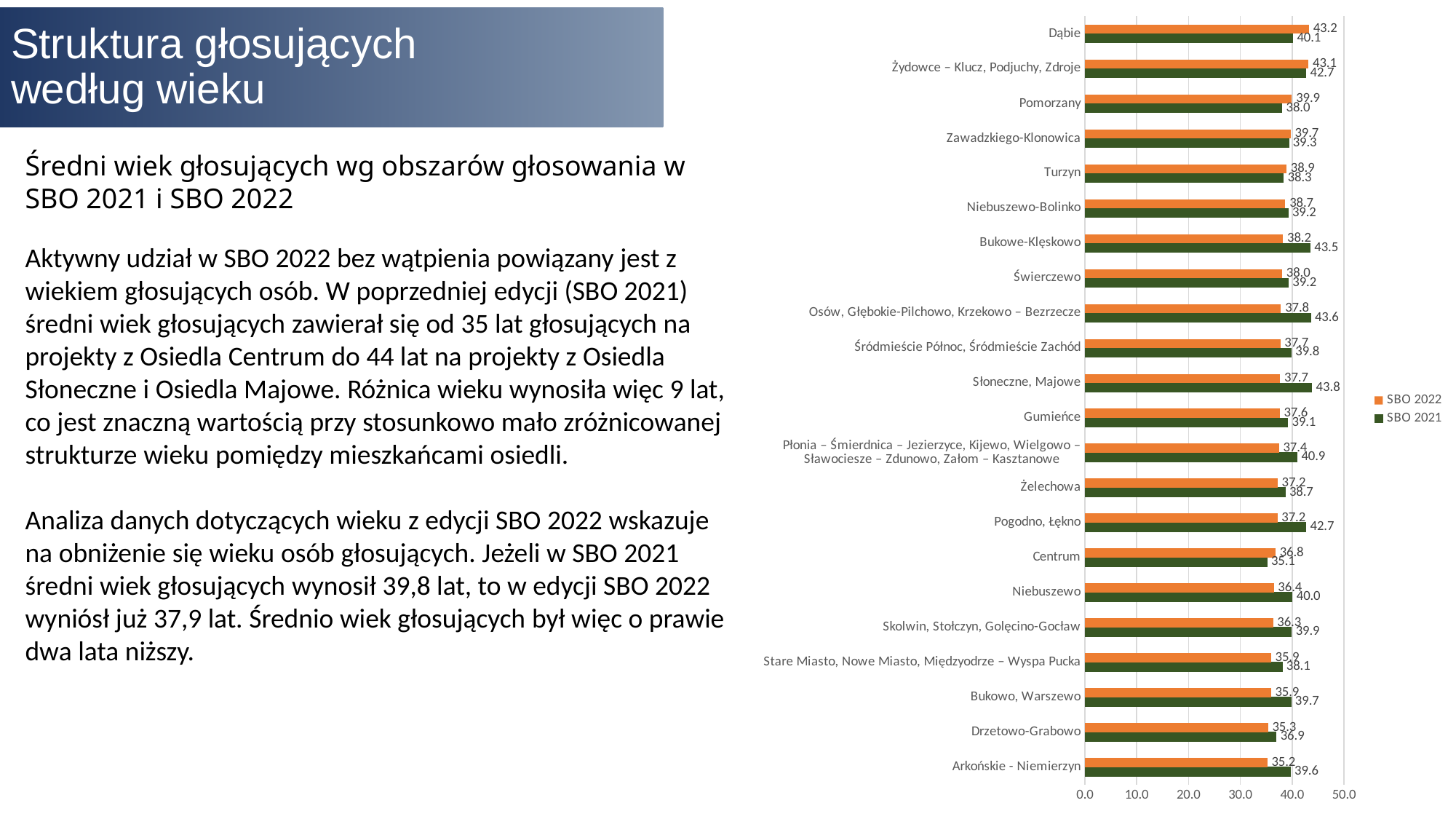
What kind of chart is shown on the slide? bar chart Which area has the highest SBO 2022 value? Dąbie What is the difference between the SBO 2021 and SBO 2022 values for Pogodno, Łękno? 5.5 Is the SBO 2021 value for Drzetowo-Grabowo greater or less than 40.0? less Which area has the lowest SBO 2022 value? Arkońskie - Niemierzyn Which area has the lowest SBO 2021 value? Centrum How many series does the legend list? 2 What is the SBO 2022 value for Dąbie? 43.2 What is the SBO 2021 value for Bukowe-Klęskowo? 43.5 What is the SBO 2021 value for Centrum? 35.1 For Centrum, which is larger: the SBO 2022 value or the SBO 2021 value? SBO 2022 How many areas are shown on the chart? 22